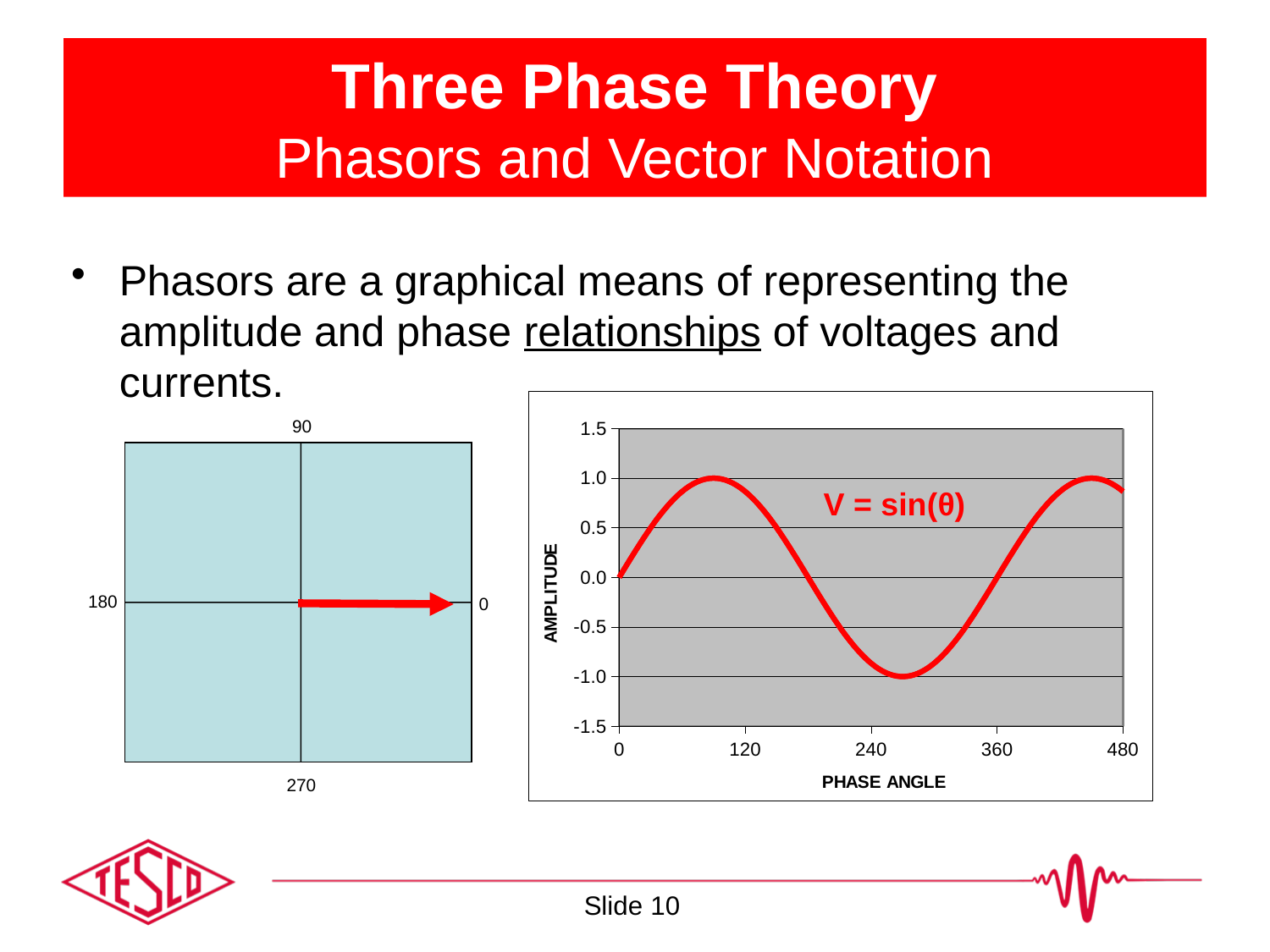
In the line chart, does the amplitude rise or fall between phase angles 120 and 240? fall In the line chart, what is the label of the vertical axis? AMPLITUDE In the line chart, what is the amplitude at a phase angle of 0? 0.0 In the line chart, is the amplitude at a phase angle of 480 greater or less than 0.5? greater In the line chart, what is the amplitude at a phase angle of 360? 0.0 In the line chart, what is the lowest amplitude value the curve reaches? -1.0 In the line chart, what is the label of the horizontal axis? PHASE ANGLE In the line chart, is the amplitude at a phase angle of 240 greater or less than -0.5? less What kind of chart is shown on the right side of the slide? line chart In the line chart, what is the highest amplitude value the curve reaches? 1.0 In the line chart, is the amplitude at a phase angle of 120 greater or less than 0.5? greater In the line chart, does the amplitude rise or fall between phase angles 240 and 360? rise